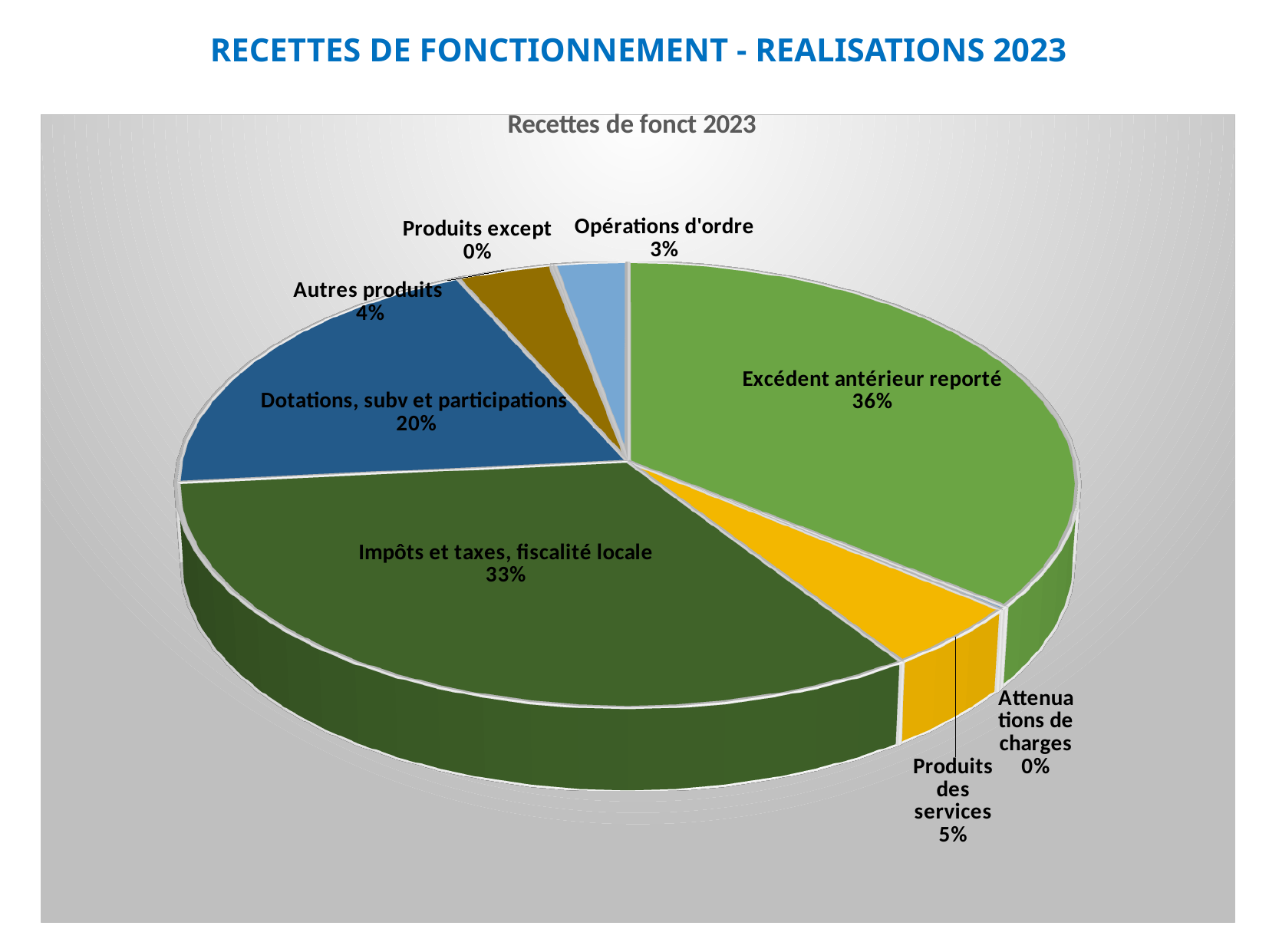
What percentage is shown for Opérations d'ordre? 3% Which is larger, Autres produits or Opérations d'ordre? Autres produits What is the difference in percentage points between Excédent antérieur reporté and Impôts et taxes, fiscalité locale? 3 What percentage is shown for Produits des services? 5% What share of the pie does Impôts et taxes, fiscalité locale represent? 33% What is the difference in percentage points between Dotations, subv et participations and Produits des services? 15 What is the title of the chart? Recettes de fonct 2023 What percentage is shown for Dotations, subv et participations? 20% How many categories are shown in the pie chart? 8 What type of chart is shown on the slide? Pie chart What share of the pie does Excédent antérieur reporté represent? 36% Which category has the largest share of the pie? Excédent antérieur reporté